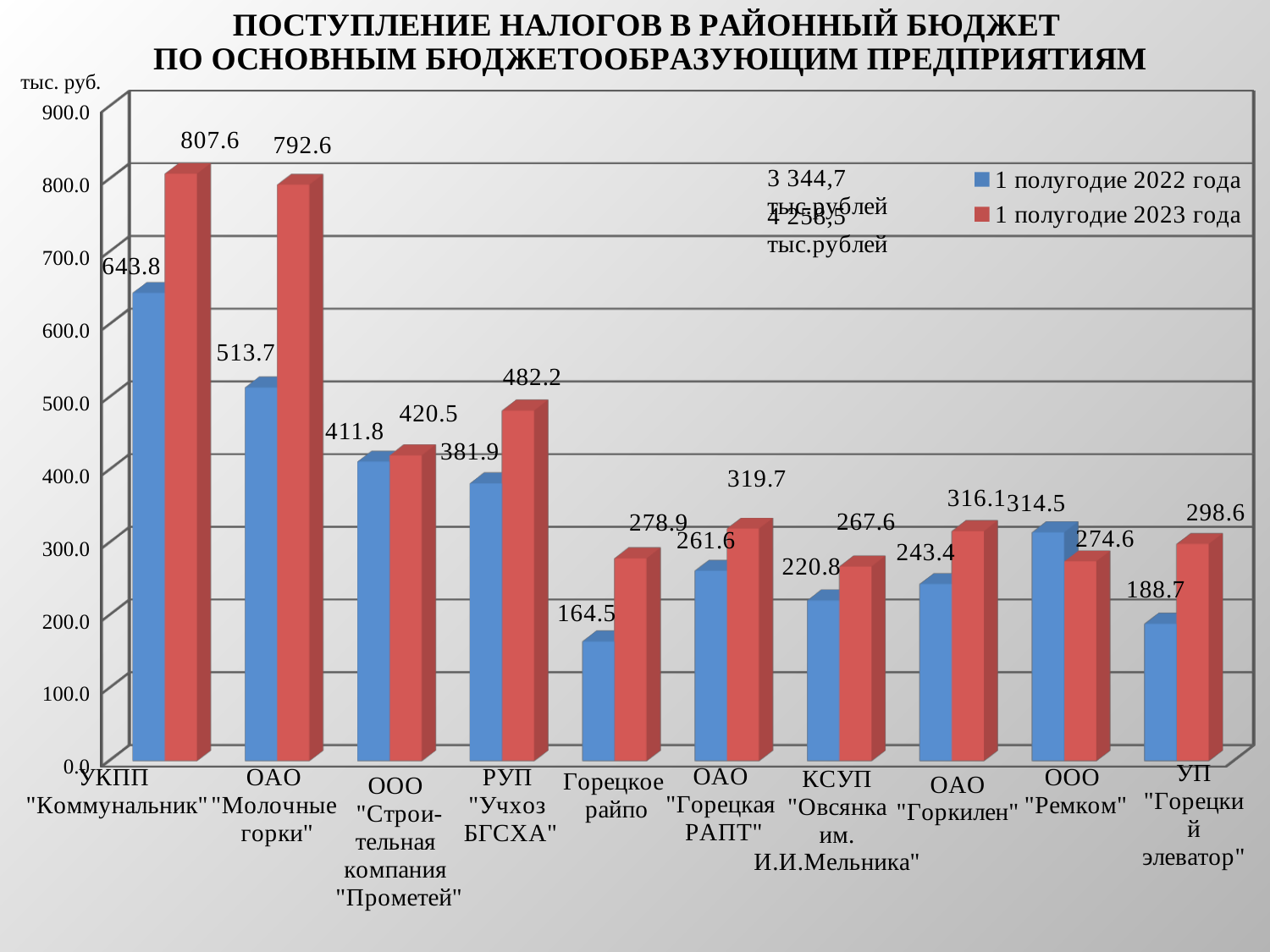
What is the value for УКПП "Коммунальник" in the 1 полугодие 2023 года series? 807.6 What is the value for УП "Горецкий элеватор" in the 1 полугодие 2023 года series? 298.6 What is the value for ООО "Ремком" in the 1 полугодие 2022 года series? 314.5 What is the difference between the 2023 and 2022 values for ОАО "Молочные горки"? 278.9 For ООО "Ремком", which series has the larger value: 1 полугодие 2022 года or 1 полугодие 2023 года? 1 полугодие 2022 года Which enterprise has the lowest value in the 1 полугодие 2023 года series? КСУП "Овсянка им. И.И.Мельника" Which enterprise has the lowest value in the 1 полугодие 2022 года series? Горецкое райпо How many enterprises are shown on the x axis? 10 What is the difference between the 2023 and 2022 values for УКПП "Коммунальник"? 163.8 How many series does the legend list? 2 What kind of chart is shown on the slide? Bar chart Which enterprise has the highest value in the 1 полугодие 2023 года series? УКПП "Коммунальник"